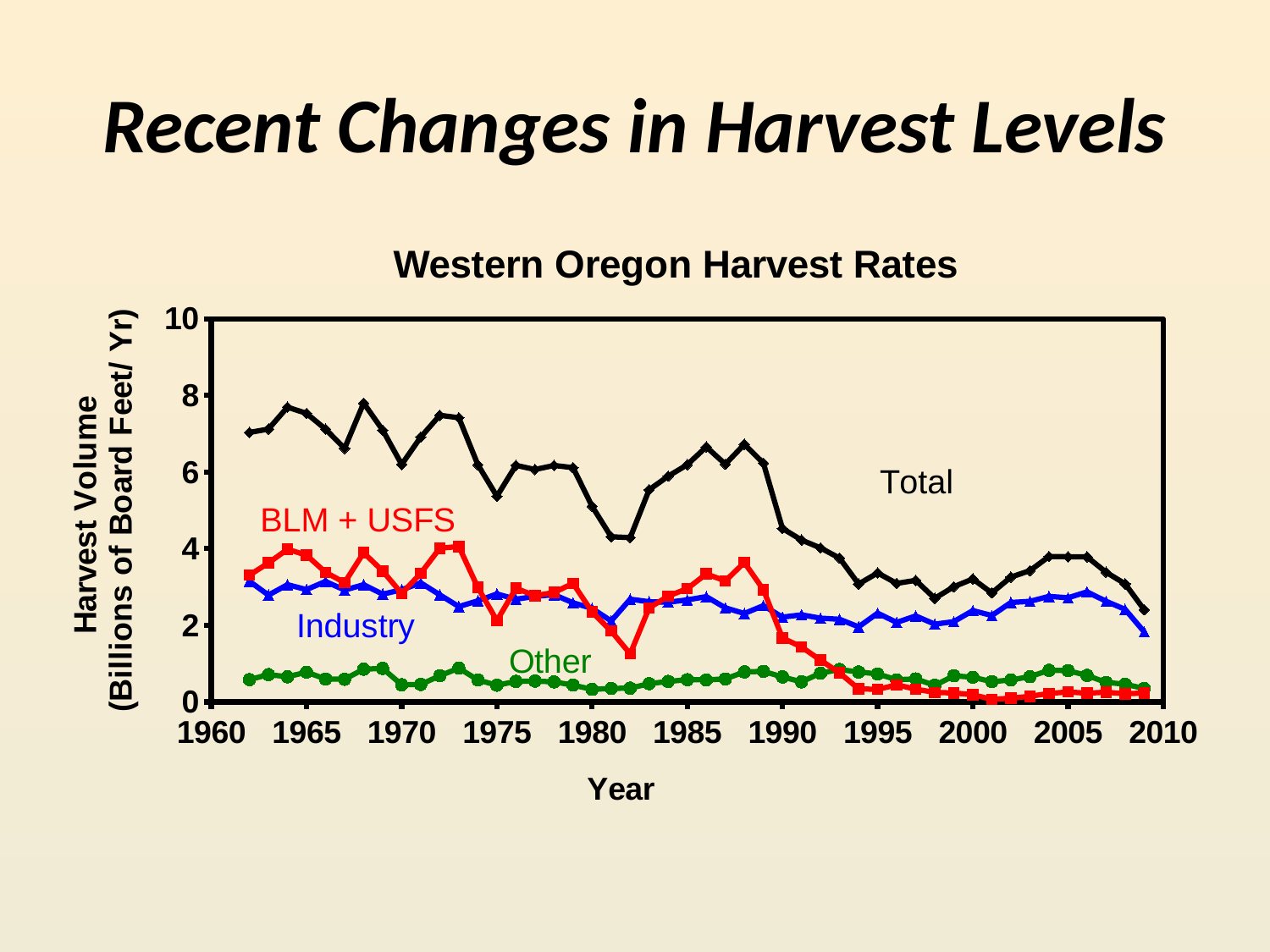
Is the Total value in 1964 greater or less than 6? greater What is the label on the vertical axis of the chart? Harvest Volume (Billions of Board Feet/ Yr) What kind of chart is shown on the slide? line chart In 2005, which is larger: the Industry value or the BLM + USFS value? Industry Is the Industry value in 1990 greater or less than 4? less Which series has the lowest value in 1970? Other Is the Other value in 1980 greater or less than 2? less What is the title of the chart? Western Oregon Harvest Rates Which series has the highest value in 1970? Total How many data series are plotted on the Western Oregon Harvest Rates chart? 4 Does the BLM + USFS series rise or fall between 1988 and 2009? fall